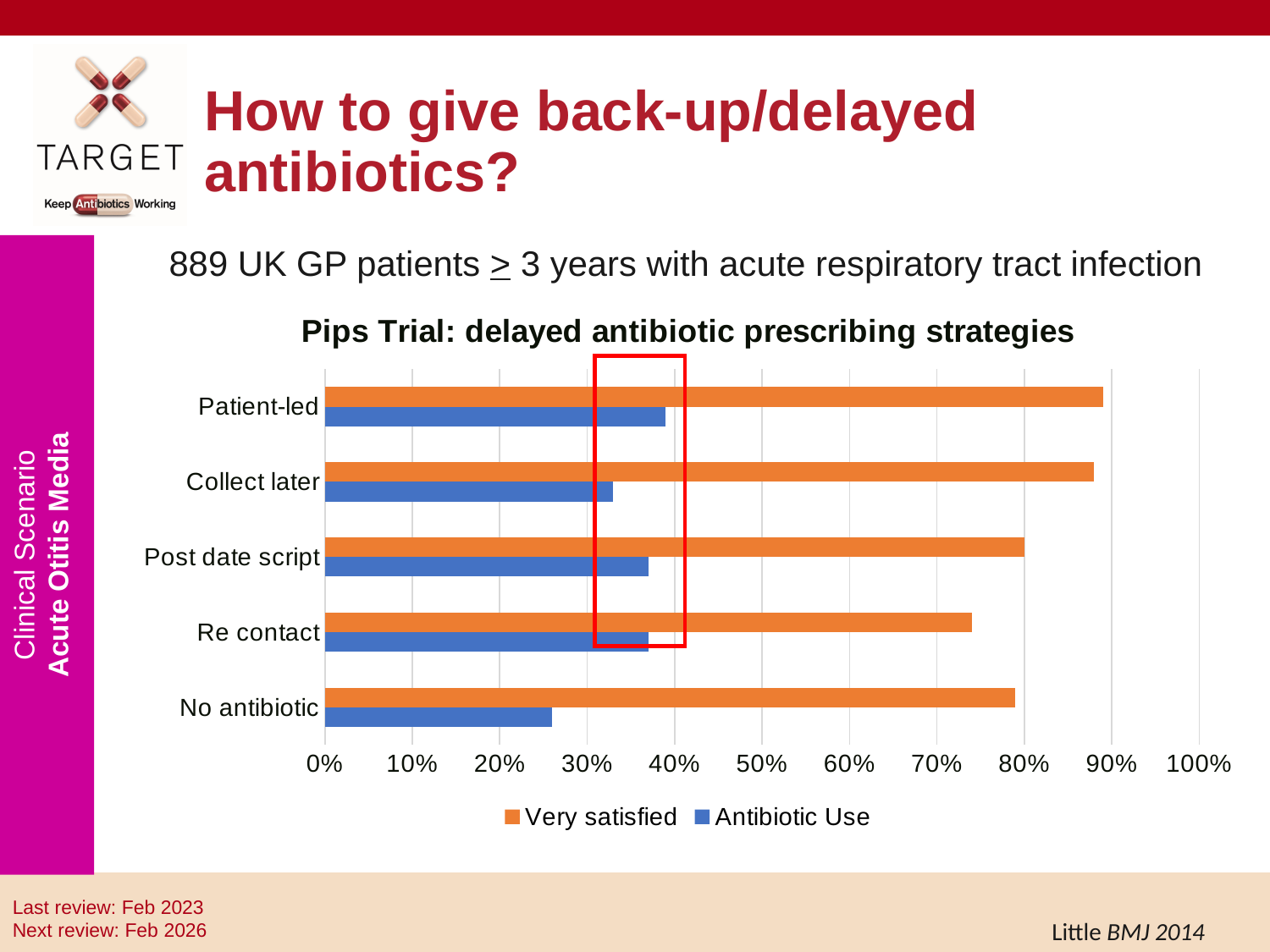
Which strategy has the lowest 'Antibiotic Use' value? No antibiotic How many prescribing strategies (categories) are shown on the chart? 5 Which colour represents the 'Antibiotic Use' series? Blue How many series does the chart legend list? 2 What kind of chart is shown on the slide? Bar chart What is the title of the chart? Pips Trial: delayed antibiotic prescribing strategies Is the 'Antibiotic Use' value for No antibiotic greater or less than 30%? less Which has the larger 'Antibiotic Use' value: Collect later or Post date script? Post date script Is the 'Antibiotic Use' value for Collect later greater or less than 40%? less Is the 'Very satisfied' value for Re contact greater or less than 80%? less Which strategy has the lowest 'Very satisfied' value? Re contact